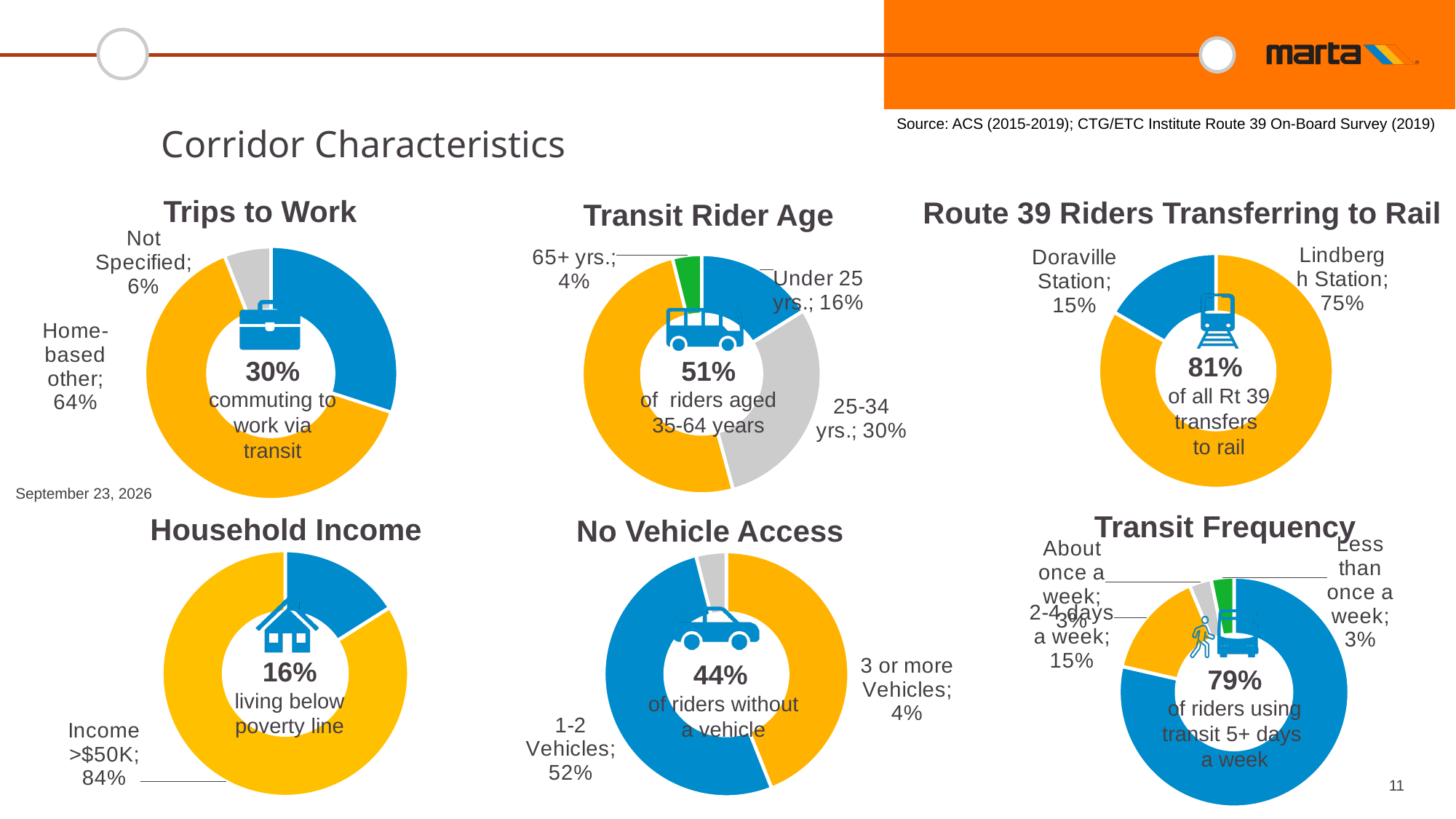
In the Transit Rider Age chart, what percentage of riders are 25-34 yrs.? 30% In the Route 39 Riders Transferring to Rail chart, what percentage is labelled 'Lindbergh Station'? 75% In the Transit Rider Age chart, what is the difference between the Under 25 yrs. share and the 65+ yrs. share? 12% In the Trips to Work chart, what percentage is labelled 'Home-based other'? 64% In the Transit Frequency chart, what percentage is labelled '2-4 days a week'? 15% In the No Vehicle Access chart, what is the difference between the 1-2 Vehicles share and the 3 or more Vehicles share? 48% In the No Vehicle Access chart, what percentage is labelled '1-2 Vehicles'? 52% In the Household Income chart, what percentage is labelled 'Income >$50K'? 84% In the Route 39 Riders Transferring to Rail chart, which is larger, Doraville Station or Lindbergh Station? Lindbergh Station What kind of chart is used for Household Income? Donut (pie) chart In the Transit Rider Age chart, which labelled age group has the smallest share? 65+ yrs. In the Trips to Work chart, what percentage is labelled 'Not Specified'? 6%